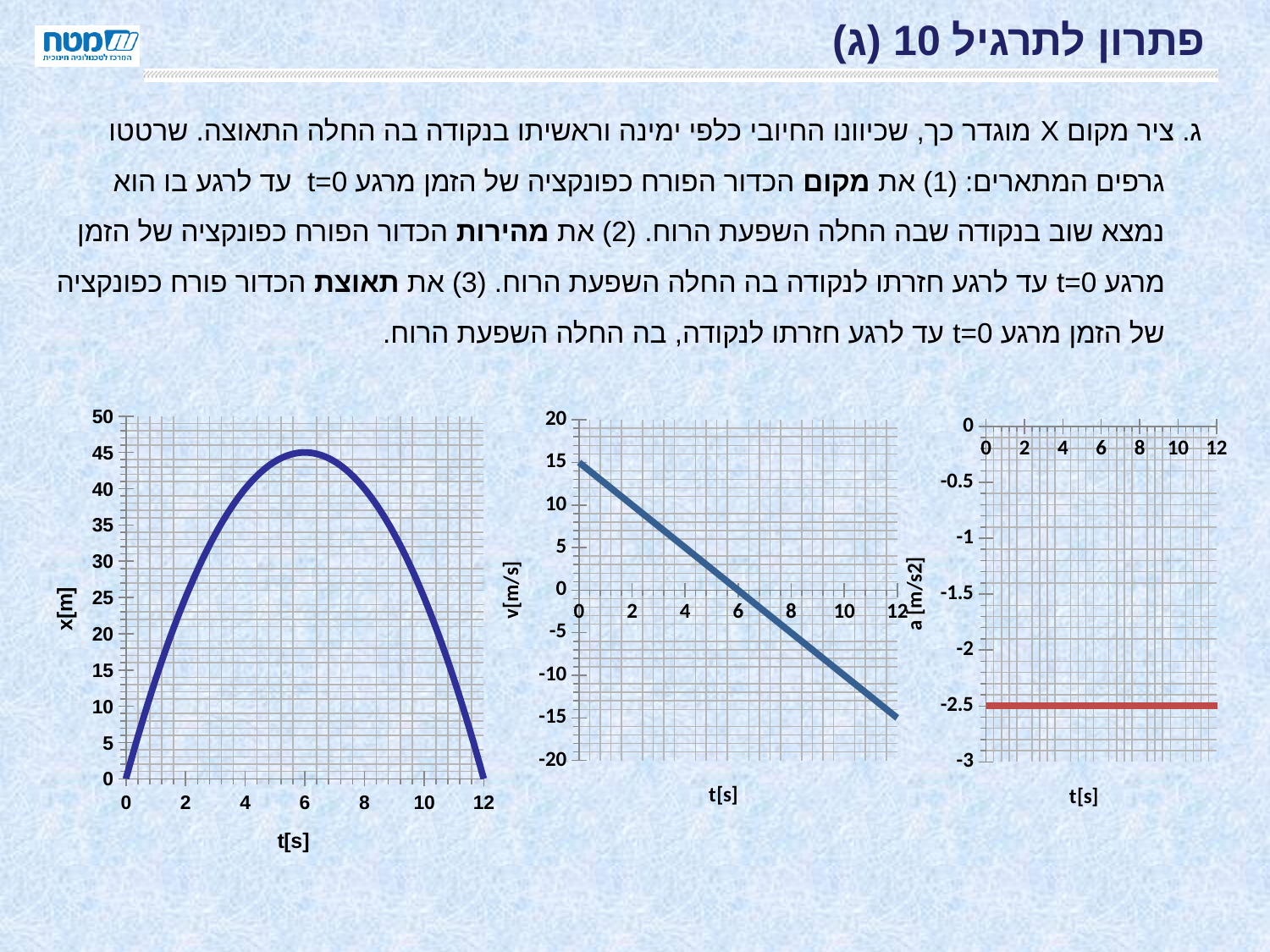
In the left chart (x[m] vs t[s]), does x rise or fall between t=6 and t=12? fall What kind of chart is the left chart (x[m] vs t[s])? line chart In the left chart (x[m] vs t[s]), at what time t[s] does x reach its maximum? 6 In the right chart (a[m/s2] vs t[s]), what is the value of a? -2.5 In the middle chart (v[m/s] vs t[s]), do the values rise or fall as t increases? fall In the middle chart (v[m/s] vs t[s]), what is the value of v at t=0? 15 In the middle chart (v[m/s] vs t[s]), at what time t[s] does v equal 0? 6 What is the label of the x axis on all three charts? t[s] In the right chart (a[m/s2] vs t[s]), do the values rise, fall, or stay constant as t increases? stay constant In the left chart (x[m] vs t[s]), is the value of x at t=2 greater or less than 20? greater In the middle chart (v[m/s] vs t[s]), what is the value of v at t=12? -15 In the left chart (x[m] vs t[s]), what is the maximum value of x[m]? 45